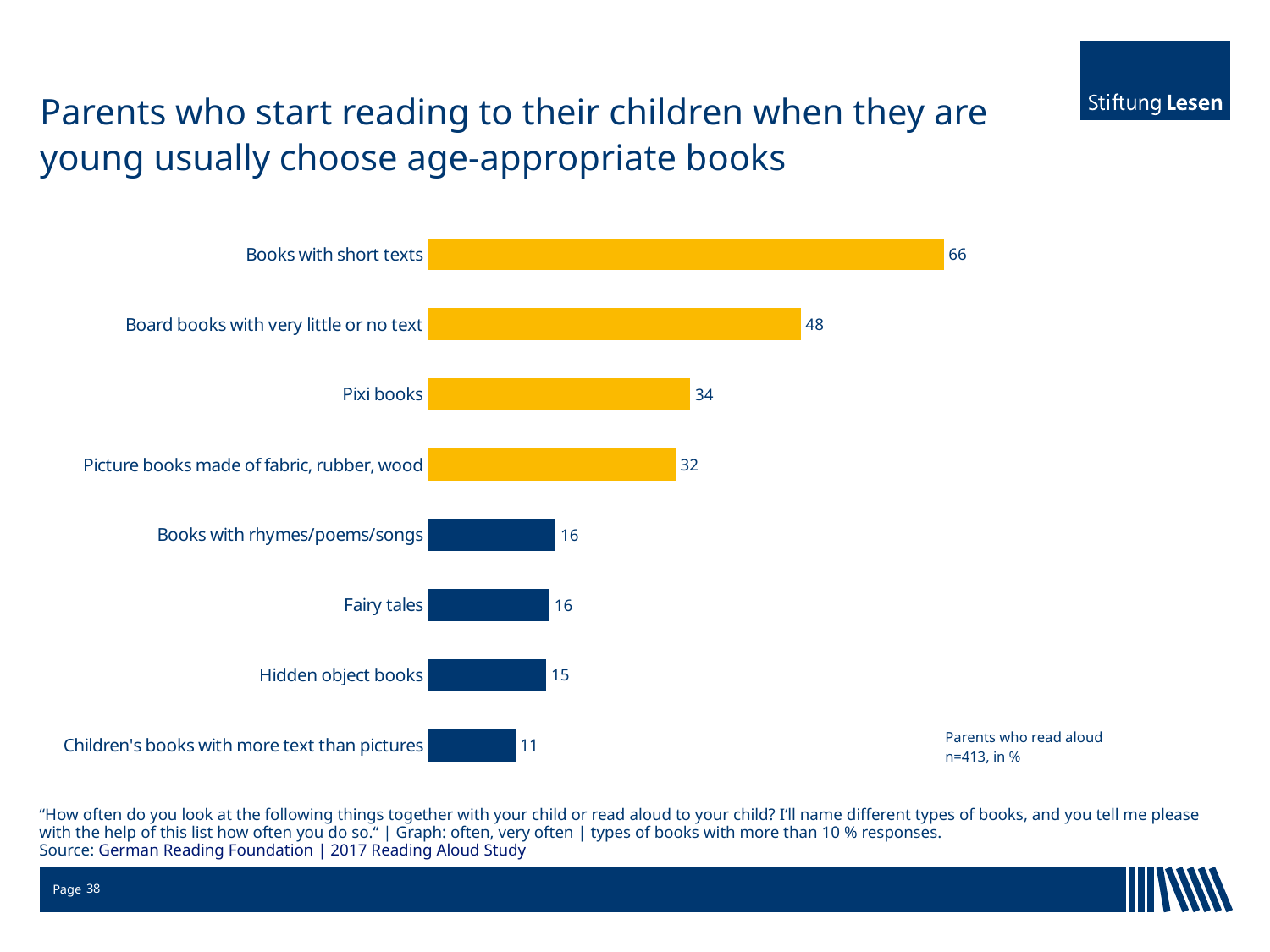
What is the difference between the values for Pixi books and Picture books made of fabric, rubber, wood? 2 Which category has the highest value? Books with short texts What is the difference between the values for Books with short texts and Board books with very little or no text? 18 What colour are the bars for the four highest categories? Yellow What is the value for Hidden object books? 15 Which is larger, the value for Board books with very little or no text or the value for Pixi books? Board books with very little or no text What is the value for Pixi books? 34 Which category has the lowest value? Children's books with more text than pictures What kind of chart is shown on the slide? Bar chart What is the value for Books with short texts? 66 How many categories are shown in the chart? 8 How many categories have a value of 16? 2